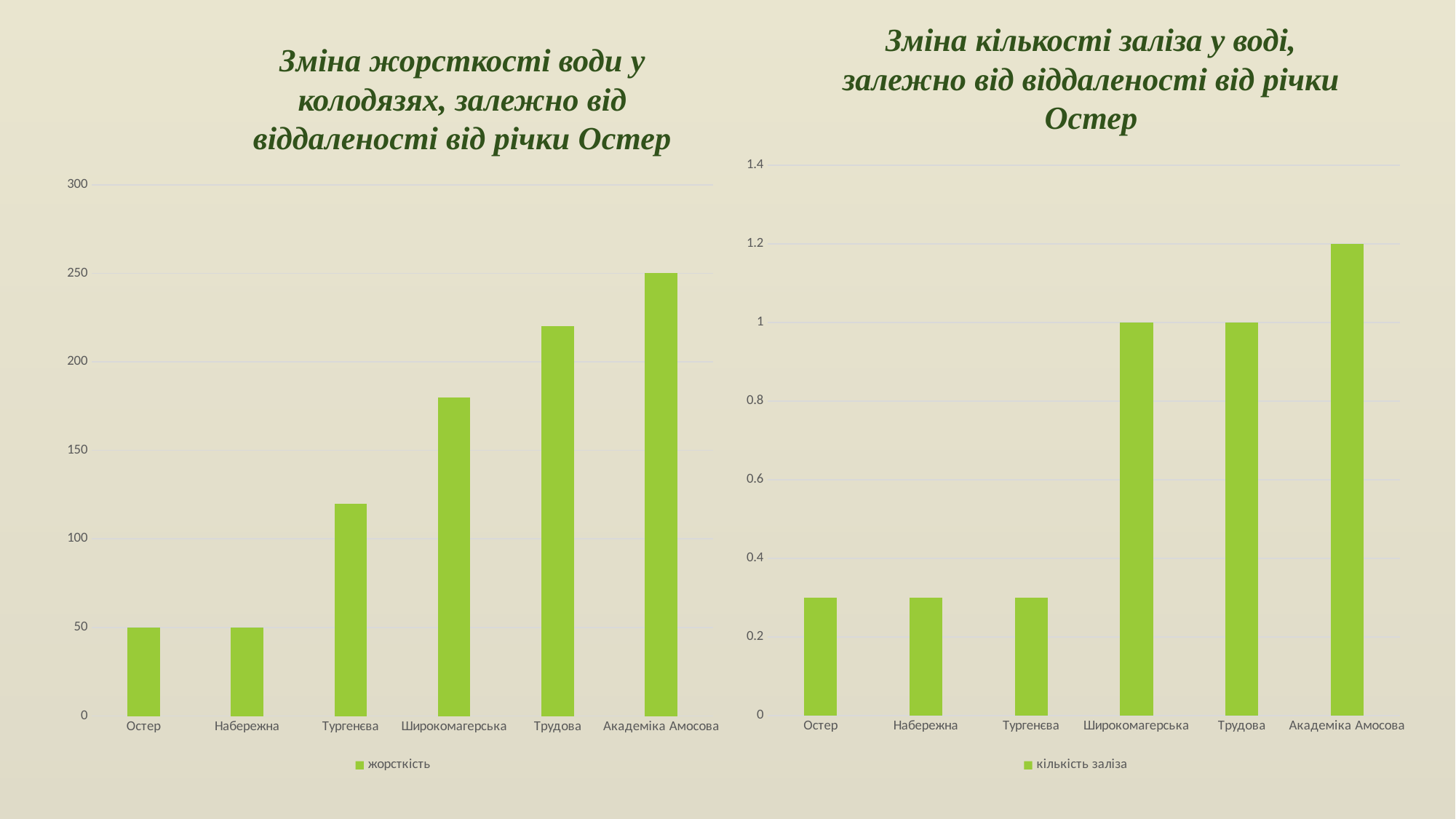
In the left chart (Зміна жорсткості води у колодязях), which category has the highest value? Академіка Амосова In the right chart (Зміна кількості заліза у воді), what is the value for Широкомагерська? 1 What kind of chart is the left chart (Зміна жорсткості води у колодязях)? bar chart In the left chart (Зміна жорсткості води у колодязях), what is the value for Остер? 50 In the left chart (Зміна жорсткості води у колодязях), is the value for Тургенєва greater or less than 100? greater How many categories are shown on the x axis of the right chart (Зміна кількості заліза у воді)? 6 In the left chart (Зміна жорсткості води у колодязях), what is the value for Академіка Амосова? 250 In the left chart (Зміна жорсткості води у колодязях), which is larger, the value for Трудова or the value for Широкомагерська? Трудова In the left chart (Зміна жорсткості води у колодязях), what is the difference between the values for Академіка Амосова and Остер? 200 In the right chart (Зміна кількості заліза у воді), is the value for Остер greater or less than 0.4? less In the right chart (Зміна кількості заліза у воді), what is the value for Академіка Амосова? 1.2 In the right chart (Зміна кількості заліза у воді), what is the difference between the values for Академіка Амосова and Трудова? 0.2